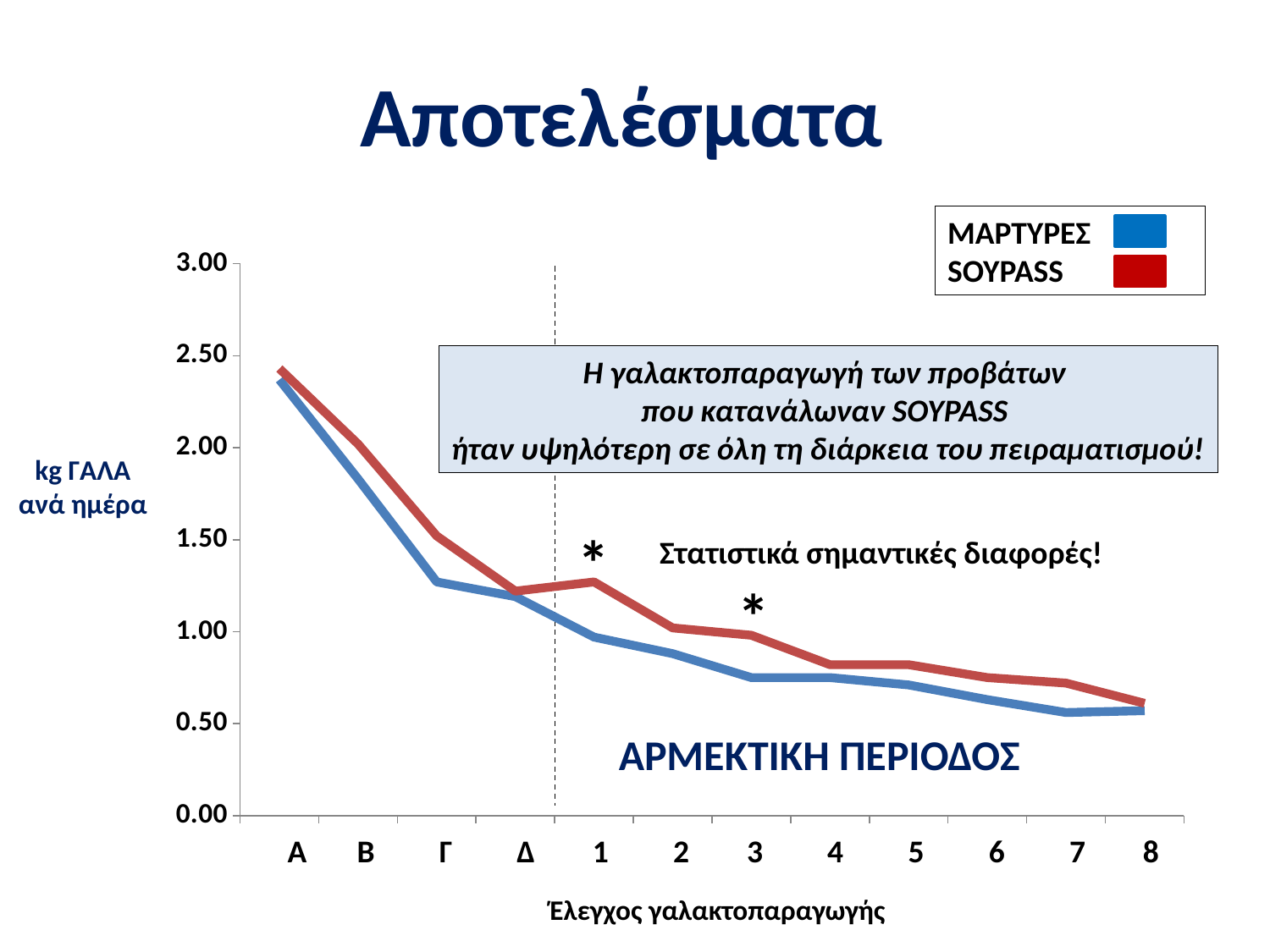
At point 3, which series has the higher value, ΜΑΡΤΥΡΕΣ or SOYPASS? SOYPASS Is the value for SOYPASS at Α greater or less than 2.00? greater Is the value for ΜΑΡΤΥΡΕΣ at 8 greater or less than 1.00? less Is the value for ΜΑΡΤΥΡΕΣ at Β greater or less than 1.50? greater At which x-axis point does SOYPASS reach its highest value? Α At which x-axis point does SOYPASS reach its lowest value? 8 How many points are there along the x axis (Έλεγχος γαλακτοπαραγωγής)? 12 What colour is the SOYPASS line in the legend? red How many series does the legend list? 2 What kind of chart is shown on the slide? line chart Do the values for SOYPASS rise or fall from Α to 8 along the x axis? fall